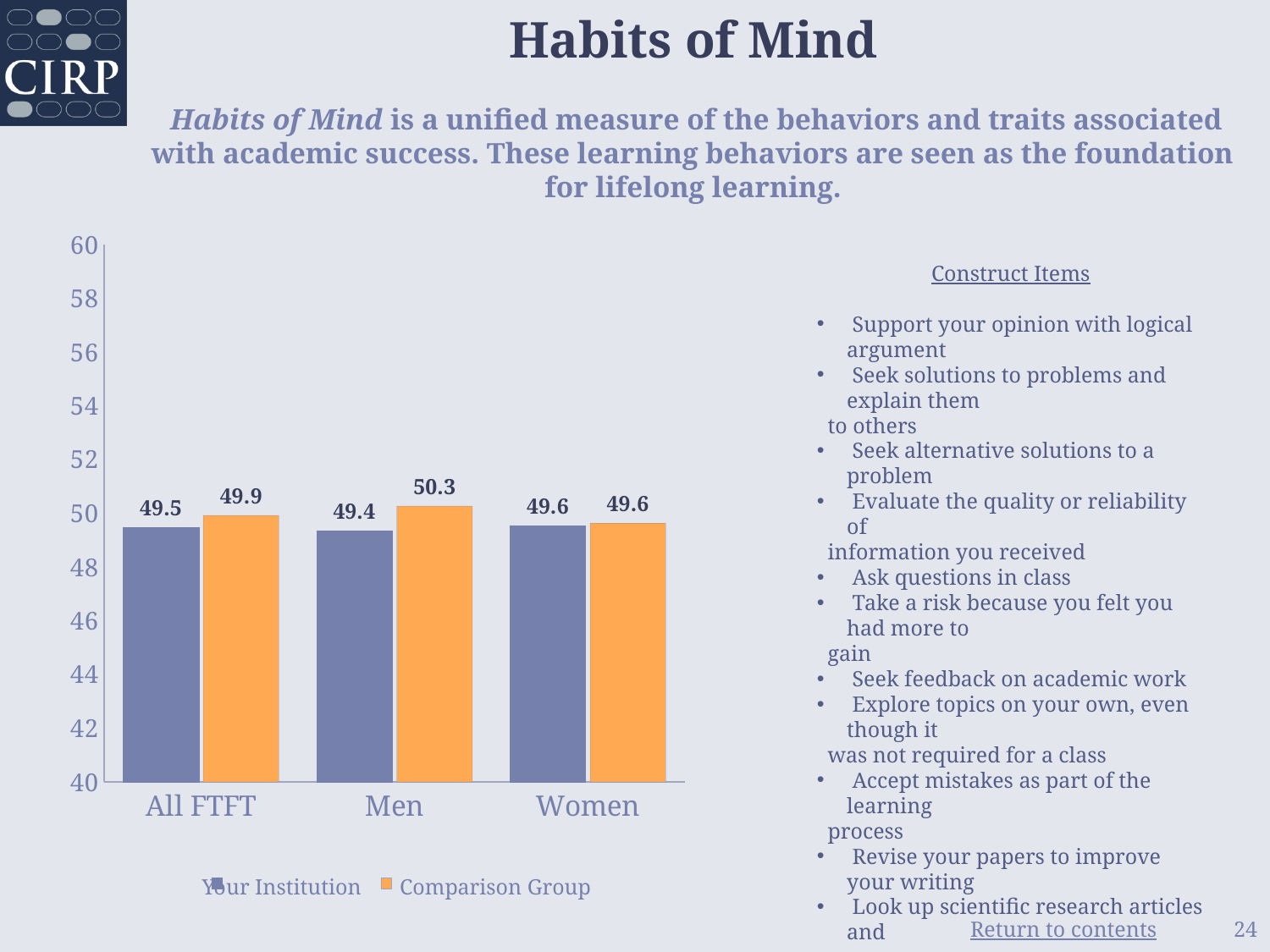
How many categories are shown on the x axis? 3 What is the difference between the Comparison Group and Your Institution values for Men? 0.9 Which category has the lowest Your Institution value? Men What is the Your Institution value for All FTFT? 49.5 For All FTFT, which is larger: Your Institution or Comparison Group? Comparison Group How many series does the legend list? 2 Is the Comparison Group value for Men greater or less than 50? greater What is the Comparison Group value for Men? 50.3 Which category has the highest Comparison Group value? Men What kind of chart is shown on the slide? bar chart What is the Your Institution value for Women? 49.6 What is the Comparison Group value for All FTFT? 49.9